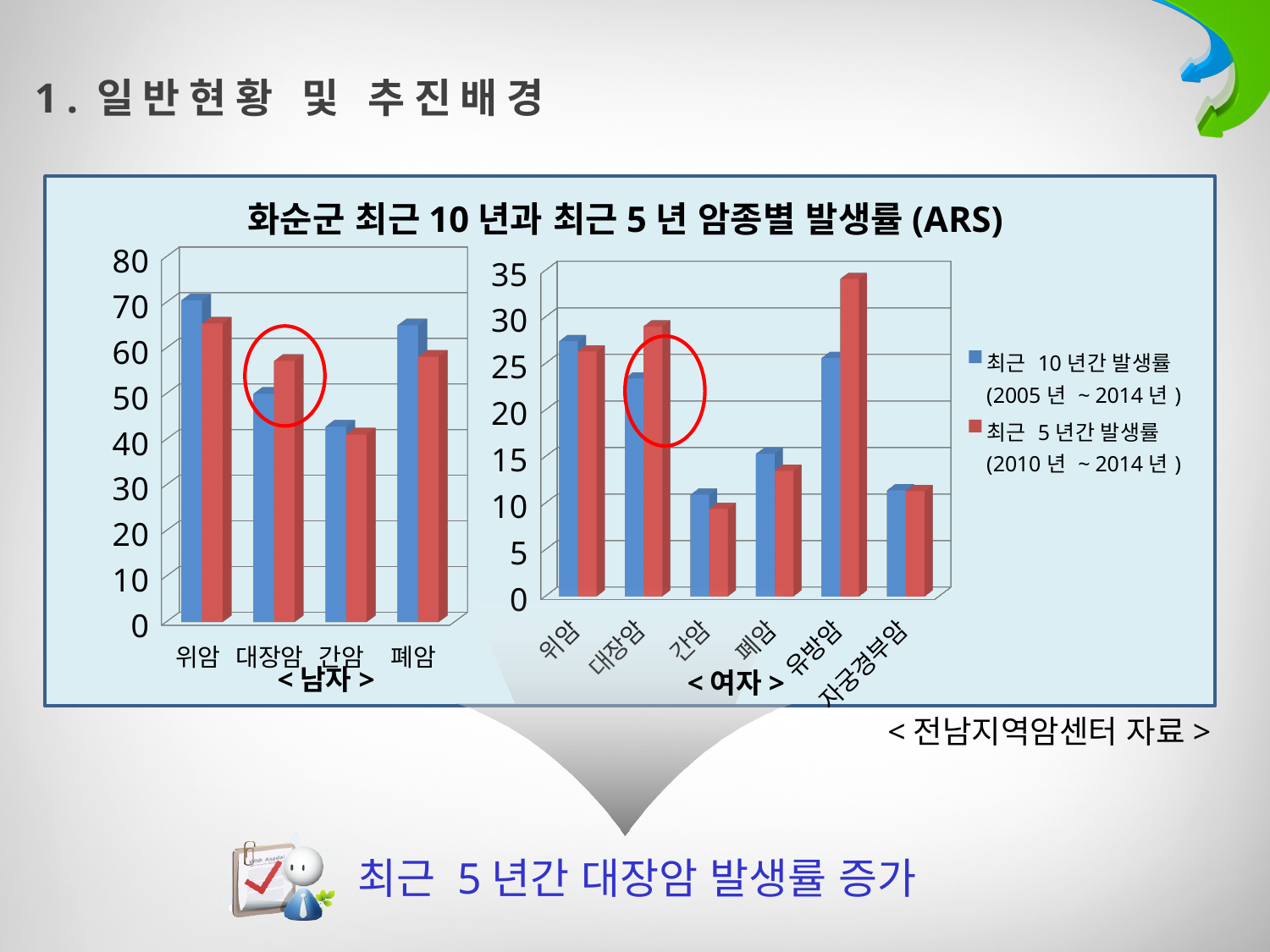
On the female (여자) chart, which cancer type has the lowest 최근 5년간 발생률 (2010년~2014년)? 간암 What kind of chart is used for the male (남자) chart on the left? bar chart On the female (여자) chart, for 유방암, which is larger: the 최근 10년간 발생률 or the 최근 5년간 발생률? 최근 5년간 발생률 How many cancer types are shown on the female (여자) chart on the right? 6 On the female (여자) chart, is the 최근 5년간 발생률 for 유방암 greater or less than 30? greater On the male (남자) chart, which cancer type has the lowest 최근 10년간 발생률 (2005년~2014년)? 간암 How many series does the legend list for the charts? 2 On the male (남자) chart, which cancer type has the highest 최근 10년간 발생률 (2005년~2014년)? 위암 On the male (남자) chart, is the 최근 10년간 발생률 for 위암 greater or less than 60? greater How many cancer types are shown on the male (남자) chart on the left? 4 On the female (여자) chart, which cancer type has the highest 최근 5년간 발생률 (2010년~2014년)? 유방암 On the male (남자) chart, for 대장암, which is larger: the 최근 10년간 발생률 or the 최근 5년간 발생률? 최근 5년간 발생률